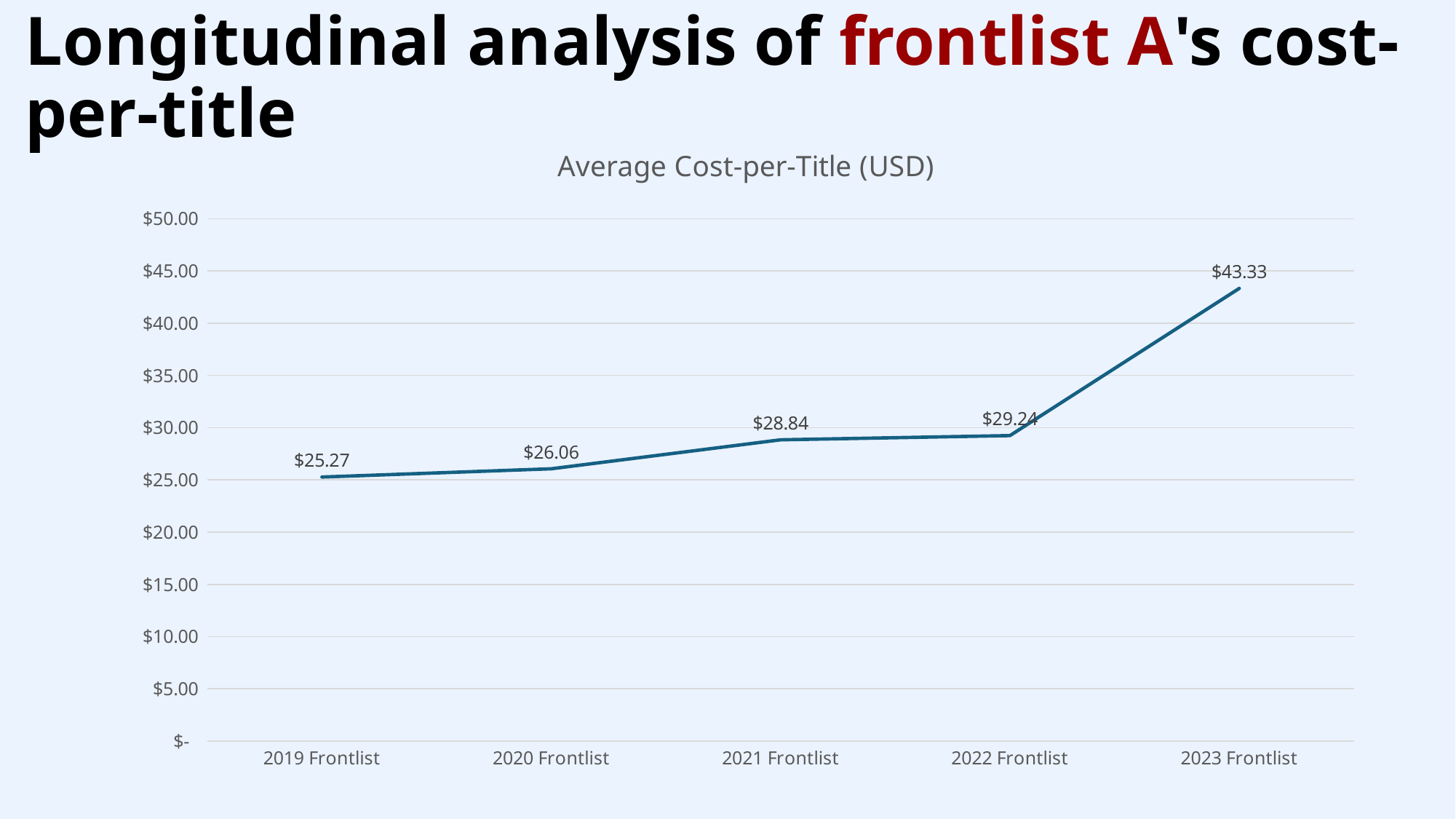
What is the difference in average cost-per-title between the 2020 Frontlist and the 2019 Frontlist? $0.79 What is the average cost-per-title for the 2023 Frontlist? $43.33 What is the difference in average cost-per-title between the 2023 Frontlist and the 2022 Frontlist? $14.09 Is the average cost-per-title for the 2023 Frontlist greater or less than $40.00? greater What kind of chart is shown on the slide? line chart Which frontlist has the highest average cost-per-title? 2023 Frontlist What is the average cost-per-title for the 2021 Frontlist? $28.84 Which frontlist has the lowest average cost-per-title? 2019 Frontlist What is the average cost-per-title for the 2019 Frontlist? $25.27 How many frontlists are plotted on the chart? 5 Does the average cost-per-title rise or fall from the 2019 Frontlist to the 2023 Frontlist? rise Which has a higher average cost-per-title, the 2021 Frontlist or the 2020 Frontlist? 2021 Frontlist